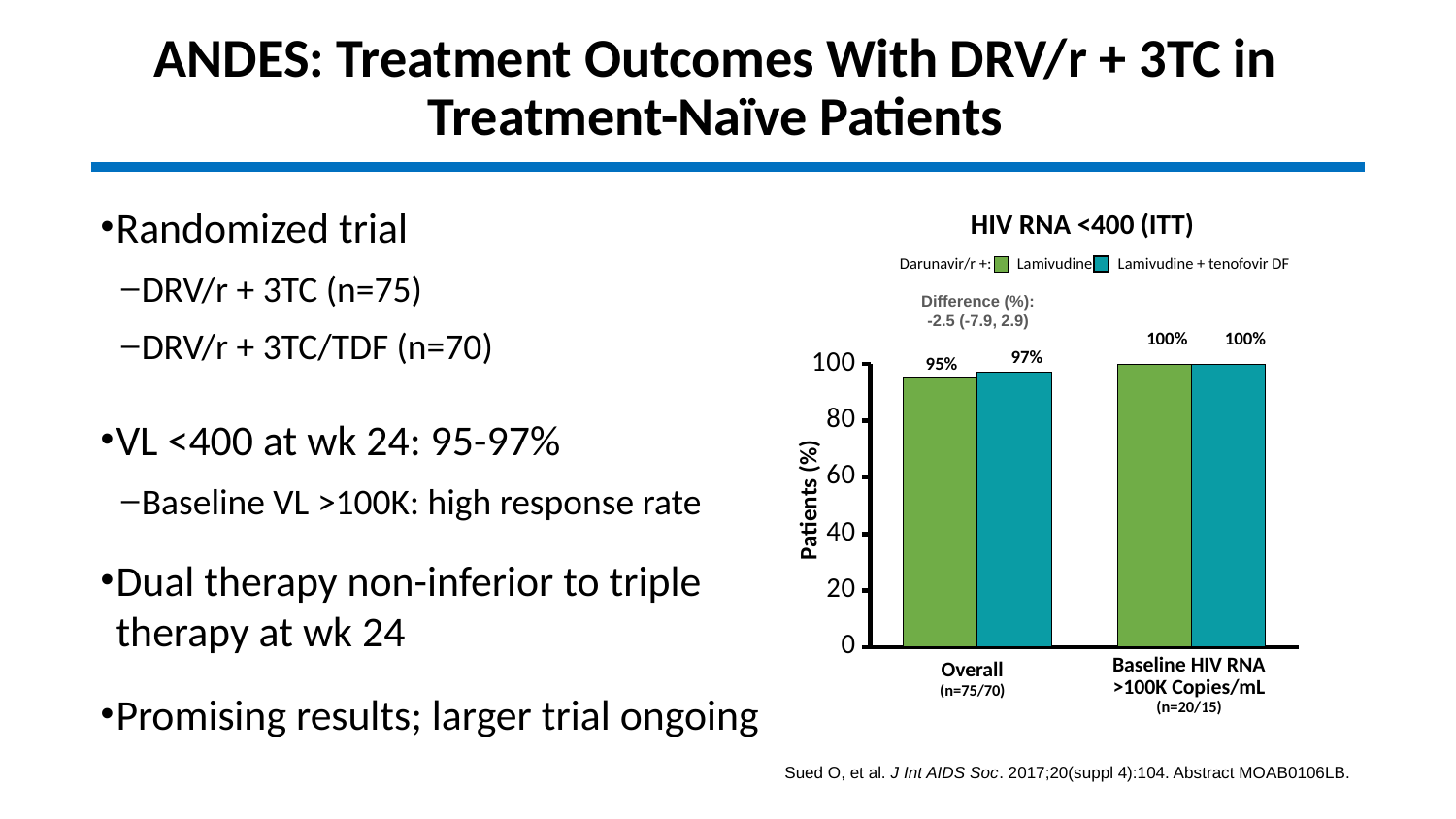
What is the difference between the Lamivudine + tenofovir DF and Lamivudine values in the Overall category? 2% In the Overall category, which series has the larger value, Lamivudine or Lamivudine + tenofovir DF? Lamivudine + tenofovir DF How many categories are shown on the x axis? 2 How many series does the legend list? 2 What is the value for Lamivudine in the Baseline HIV RNA >100K Copies/mL category? 100% What is the value for Lamivudine + tenofovir DF in the Overall category? 97% Is the value for Lamivudine in the Overall category greater or less than 80? greater What is the label of the y axis? Patients (%) What kind of chart is shown? bar chart What is the title of the chart? HIV RNA <400 (ITT) What is the value for Lamivudine in the Overall category? 95% What is the value for Lamivudine + tenofovir DF in the Baseline HIV RNA >100K Copies/mL category? 100%